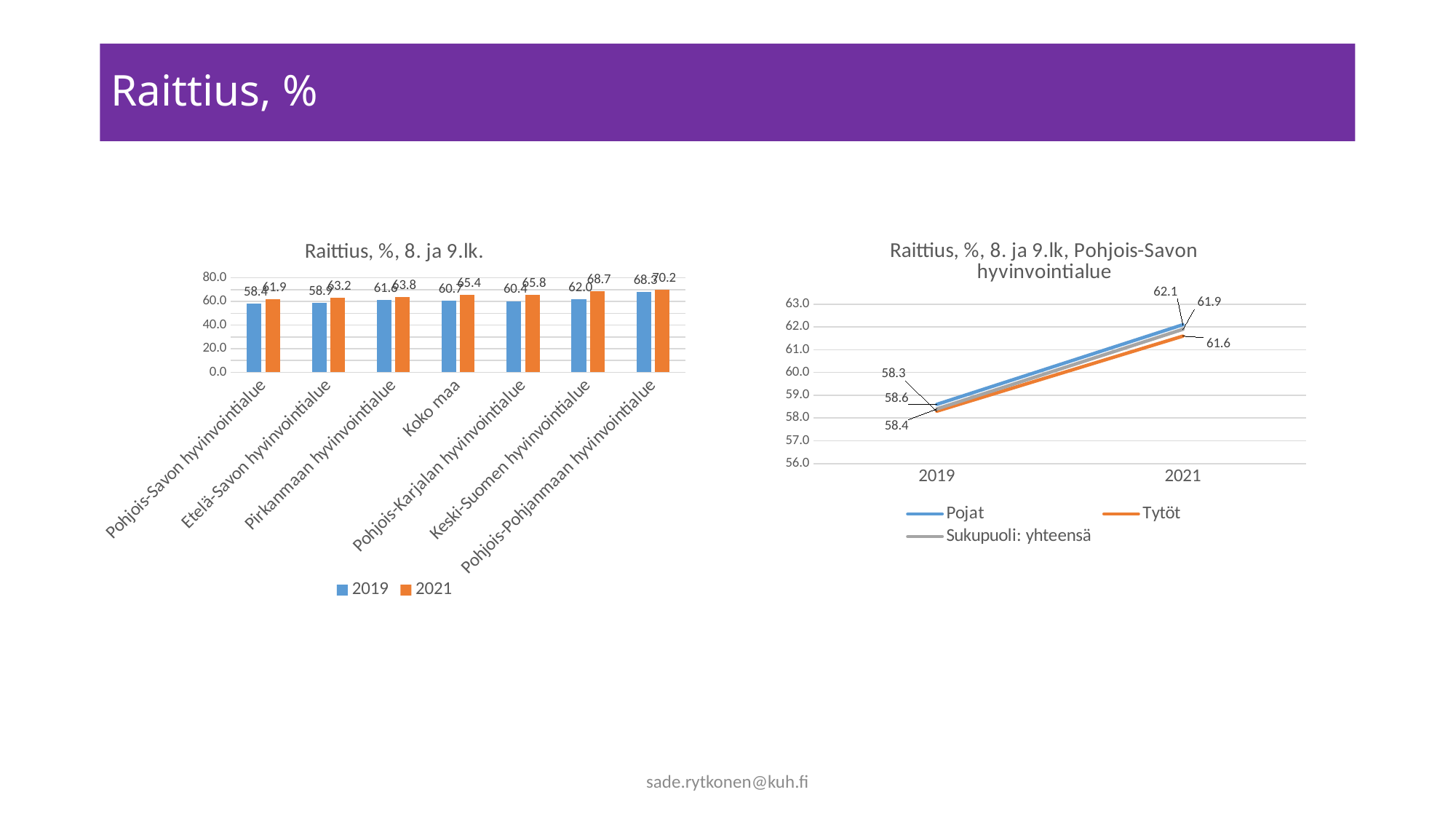
In the right chart "Raittius, %, 8. ja 9.lk, Pohjois-Savon hyvinvointialue", what is the value for Pojat in 2021? 62.1 In the left chart "Raittius, %, 8. ja 9.lk.", what is the 2021 value for Koko maa? 65.4 In the left chart "Raittius, %, 8. ja 9.lk.", which has the larger 2021 value: Pirkanmaan hyvinvointialue or Koko maa? Koko maa In the left chart "Raittius, %, 8. ja 9.lk.", what is the 2019 value for Pohjois-Savon hyvinvointialue? 58.4 In the left chart "Raittius, %, 8. ja 9.lk.", how many categories are shown on the x axis? 7 In the right chart "Raittius, %, 8. ja 9.lk, Pohjois-Savon hyvinvointialue", how many series does the legend list? 3 In the left chart "Raittius, %, 8. ja 9.lk.", how much higher is the 2021 value than the 2019 value for Keski-Suomen hyvinvointialue? 6.7 In the left chart "Raittius, %, 8. ja 9.lk.", which category has the lowest 2019 value? Pohjois-Savon hyvinvointialue In the right chart "Raittius, %, 8. ja 9.lk, Pohjois-Savon hyvinvointialue", do the values rise or fall from 2019 to 2021? rise In the left chart "Raittius, %, 8. ja 9.lk.", how many series does the legend list? 2 In the left chart "Raittius, %, 8. ja 9.lk.", which category has the highest 2021 value? Pohjois-Pohjanmaan hyvinvointialue What kind of chart is the left chart titled "Raittius, %, 8. ja 9.lk."? bar chart